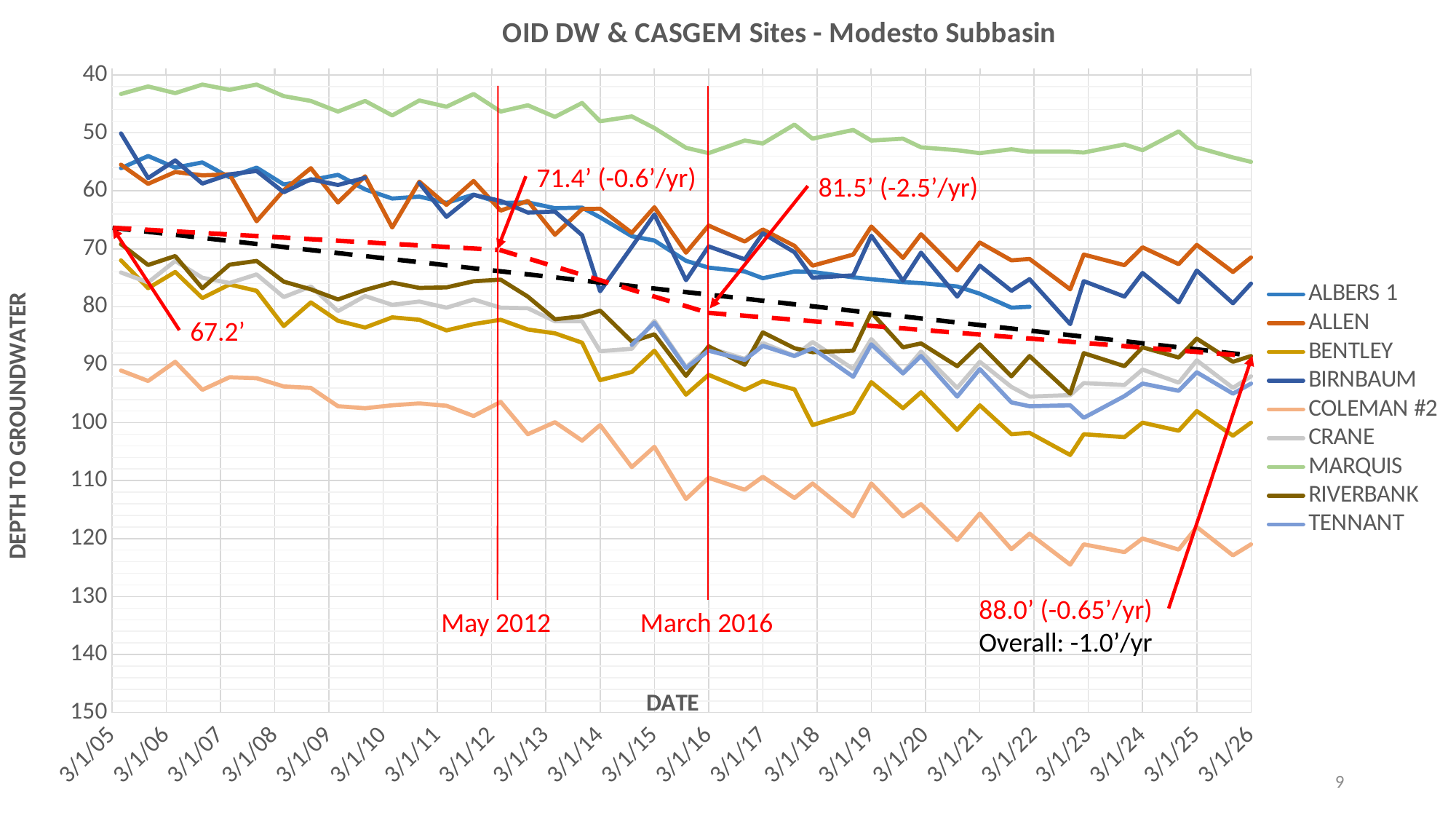
What kind of chart is shown on the slide? line chart According to the annotation, what is the trend-line depth value at May 2012? 71.4' Which series has the smallest depth-to-groundwater values across the chart? MARQUIS What is the label of the vertical axis? DEPTH TO GROUNDWATER Which series has the larger depth value at 3/1/26, BENTLEY or ALLEN? BENTLEY How many series does the legend list? 9 Is the value for COLEMAN #2 at 3/1/26 greater or less than 110? greater What is the title of the chart? OID DW & CASGEM Sites - Modesto Subbasin Is the value for MARQUIS at 3/1/05 greater or less than 50? less Which series has the largest depth-to-groundwater values across the chart? COLEMAN #2 Do the depth-to-groundwater values for COLEMAN #2 generally increase or decrease from 3/1/05 to 3/1/26? increase According to the annotation, what is the rate of change after March 2016? -0.65'/yr